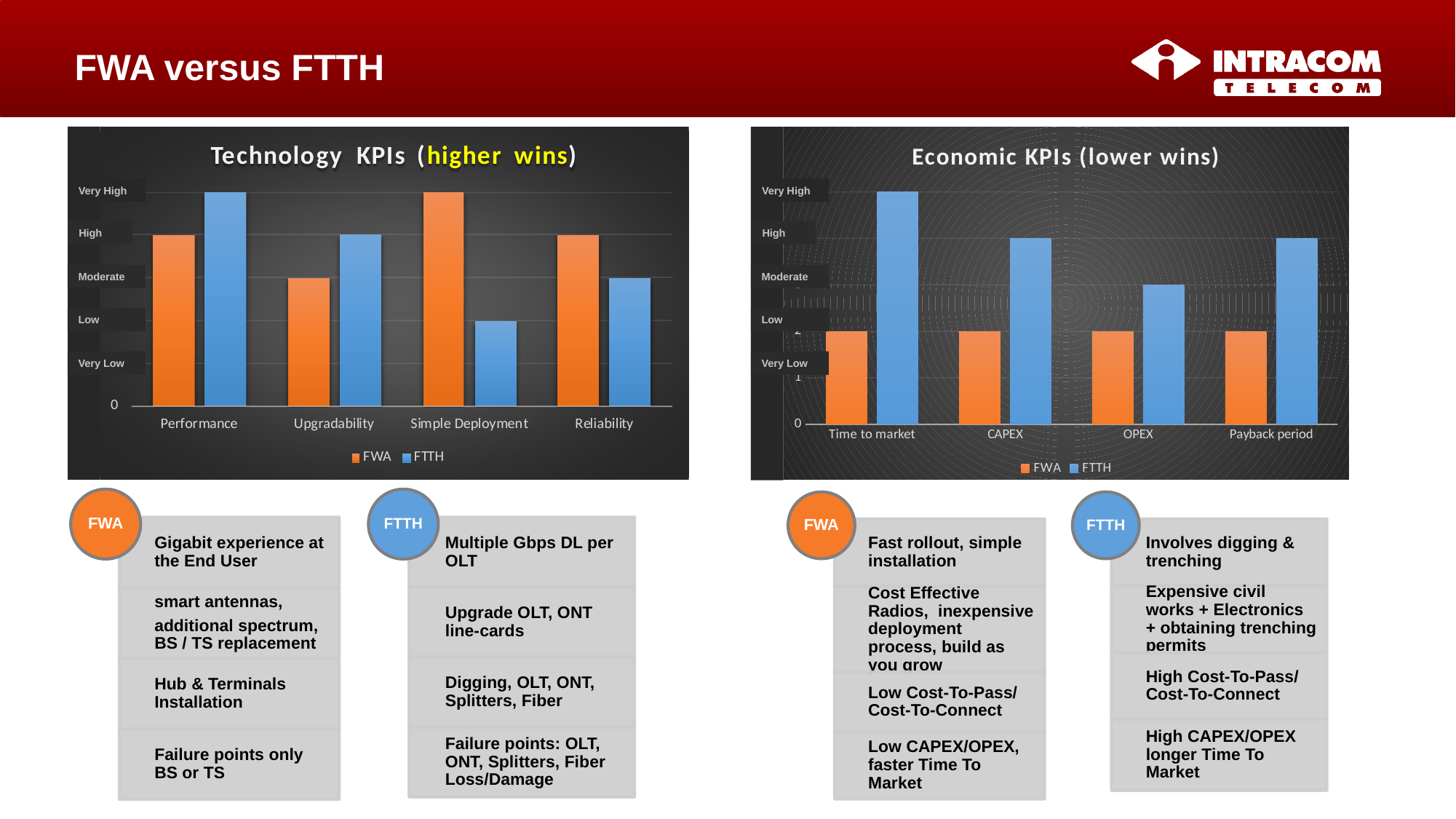
In the Economic KPIs chart, what level does the FTTH bar reach for Time to market? Very High In the Economic KPIs chart, which colour represents the FWA series? Orange In the Technology KPIs chart, which series has the higher bar for Reliability, FWA or FTTH? FWA In the Technology KPIs chart, how many categories are shown on the x axis? 4 In the Technology KPIs chart, what level does the FWA bar reach for Simple Deployment? Very High In the Economic KPIs chart, what level does the FTTH bar reach for OPEX? Moderate In the Economic KPIs chart, which category has the highest FTTH bar? Time to market In the Technology KPIs chart, how many series does the legend list? 2 In the Economic KPIs chart, what level does the FWA bar reach for CAPEX? Low What kind of chart is the Economic KPIs chart? Bar chart In the Technology KPIs chart, what level does the FTTH bar reach for Performance? Very High In the Technology KPIs chart, what level does the FTTH bar reach for Simple Deployment? Low